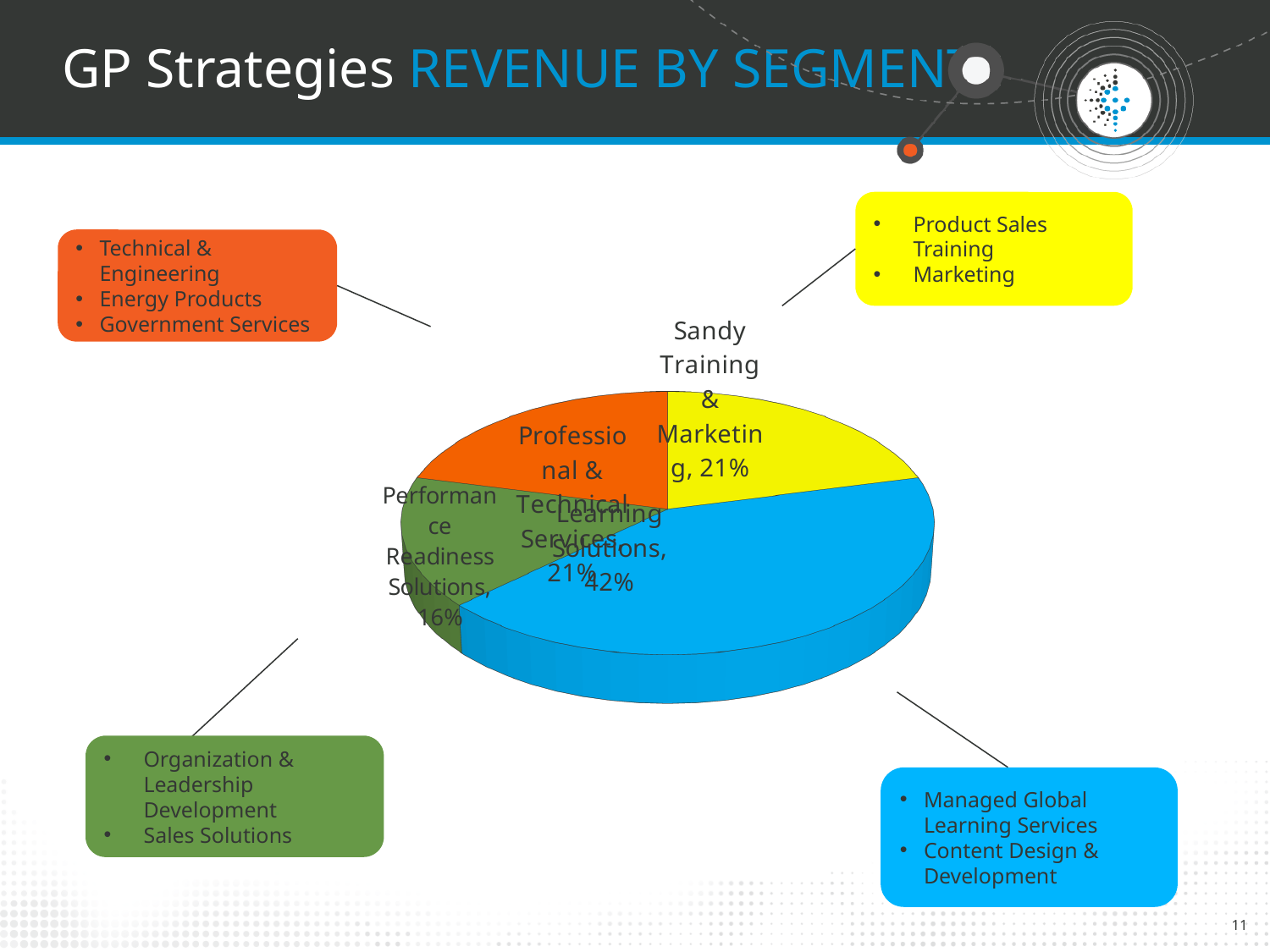
What share of revenue does the Professional & Technical Services segment account for? 21% What colour is the Learning Solutions slice of the pie chart? Blue What kind of chart is shown on the slide? Pie chart What share of revenue does the Sandy Training & Marketing segment account for? 21% How many segments are shown in the pie chart? 4 What share of revenue does the Performance Readiness Solutions segment account for? 16% Which is larger: the Learning Solutions share or the Sandy Training & Marketing share? Learning Solutions Which segment has the smallest share of revenue? Performance Readiness Solutions What share of revenue does the Learning Solutions segment account for? 42% How many percentage points larger is the Learning Solutions share than the Performance Readiness Solutions share? 26 What is the title of the slide containing the chart? GP Strategies REVENUE BY SEGMENT Which segment has the largest share of revenue? Learning Solutions